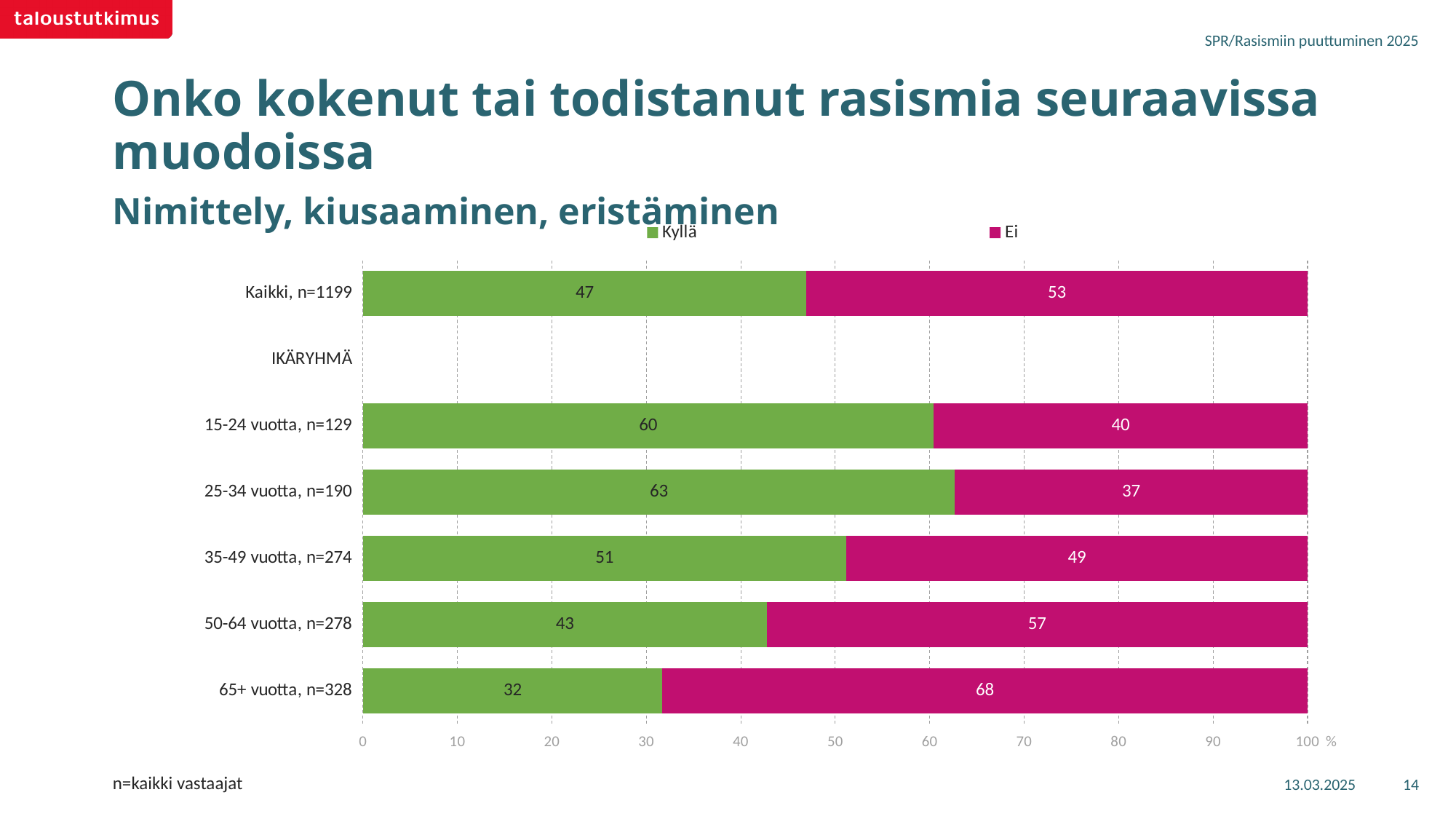
What is the difference between the Ei values for 65+ vuotta, n=328 and 15-24 vuotta, n=129? 28 What is the Kyllä value for 25-34 vuotta, n=190? 63 Which age group has the lowest Kyllä value? 65+ vuotta, n=328 What is the Ei value for 65+ vuotta, n=328? 68 Which age group has the highest Kyllä value? 25-34 vuotta, n=190 What colour represents the Ei series? magenta How many series does the legend list? 2 What kind of chart is shown on the slide? stacked bar chart Which is larger, the Kyllä value for 35-49 vuotta, n=274 or for 50-64 vuotta, n=278? 35-49 vuotta, n=274 What is the Kyllä value for Kaikki, n=1199? 47 What is the total of the stacked bar for 50-64 vuotta, n=278? 100 Is the Kyllä value for 15-24 vuotta, n=129 greater or less than 50? greater